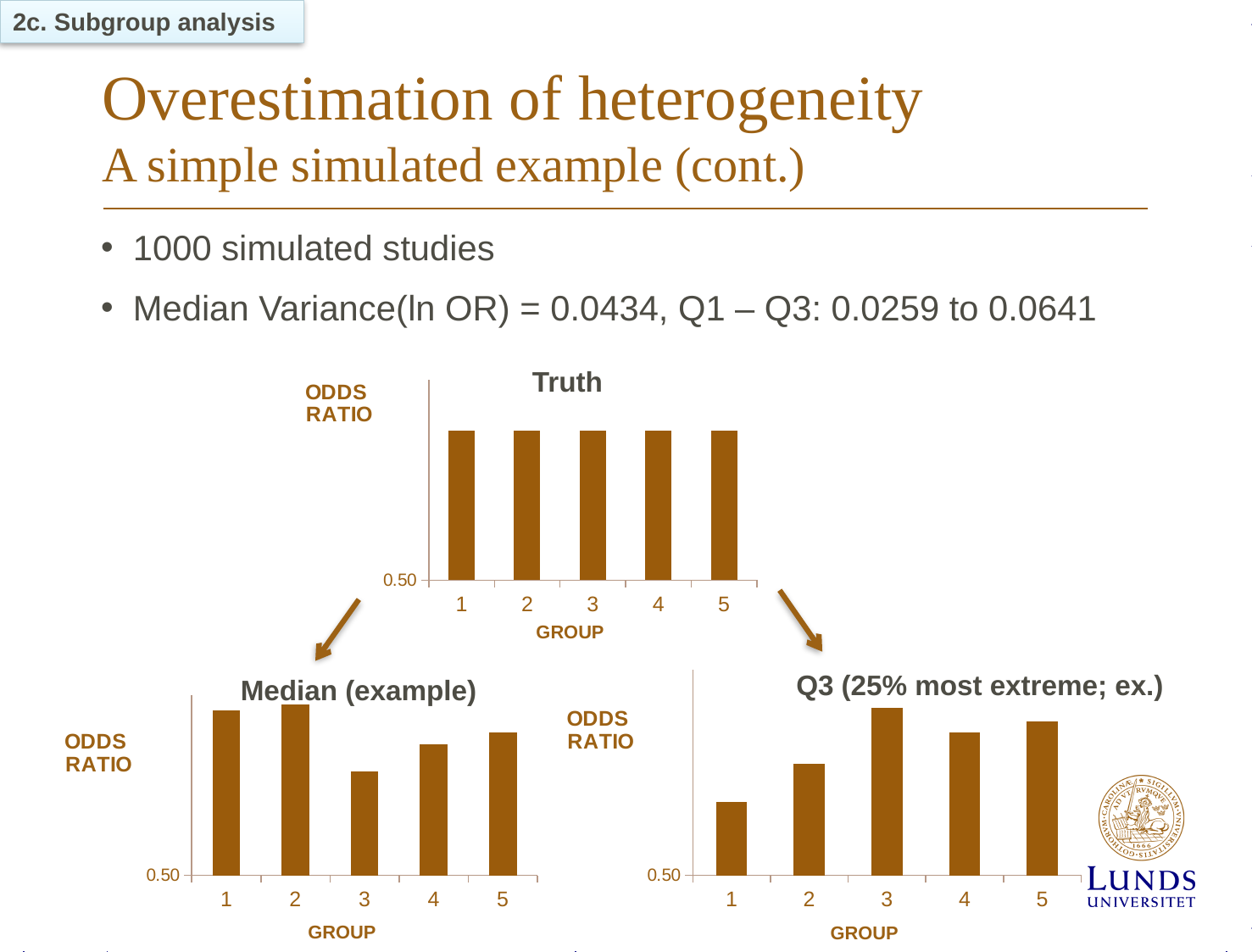
How many charts are shown on the slide? 3 In the "Median (example)" chart, which has the larger odds ratio, group 1 or group 3? group 1 What kind of chart is the "Truth" chart? bar chart In the "Q3 (25% most extreme; ex.)" chart, which has the larger odds ratio, group 2 or group 4? group 4 In the "Median (example)" chart, which group has the highest odds ratio? 2 In the "Median (example)" chart, which group has the lowest odds ratio? 3 What is the label of the horizontal axis on the "Median (example)" chart? GROUP In the "Q3 (25% most extreme; ex.)" chart, which group has the lowest odds ratio? 1 In the "Q3 (25% most extreme; ex.)" chart, which group has the highest odds ratio? 3 What is the label of the vertical axis on the "Truth" chart? ODDS RATIO In the "Truth" chart, how many groups are plotted on the x axis? 5 In the "Q3 (25% most extreme; ex.)" chart, is the odds ratio for group 1 greater or less than 0.50? greater